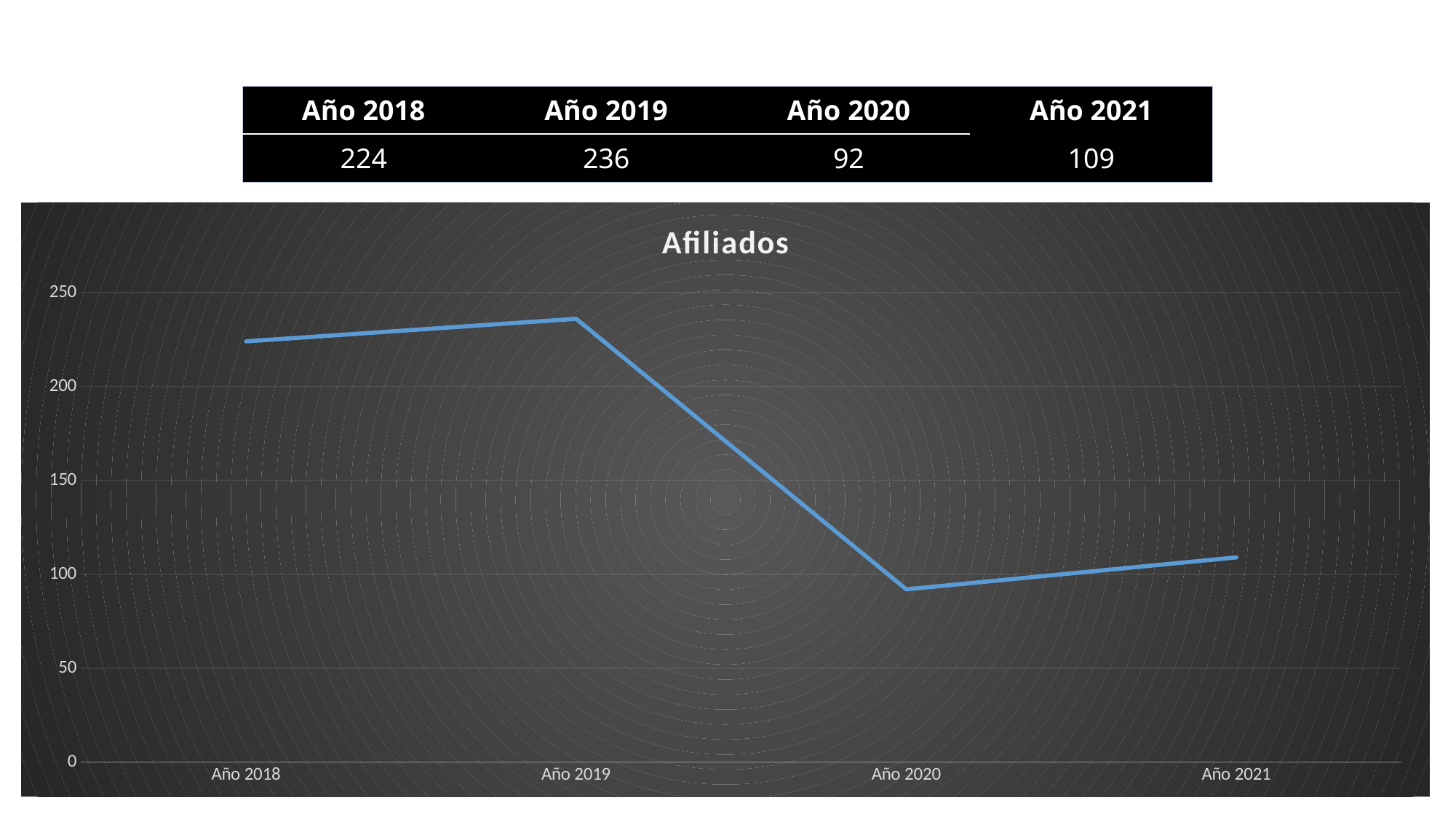
What is the difference between the values for Año 2019 and Año 2020? 144 What is the value for Año 2018? 224 How many years are plotted on the x axis of the chart? 4 What is the value for Año 2019? 236 Which year has the lowest value? Año 2020 Is the value for Año 2020 greater or less than 100? less What is the value for Año 2020? 92 Which is larger, the value for Año 2018 or the value for Año 2021? Año 2018 Which year has the highest value? Año 2019 What is the title of the chart? Afiliados What is the value for Año 2021? 109 What type of chart is shown on the slide? line chart